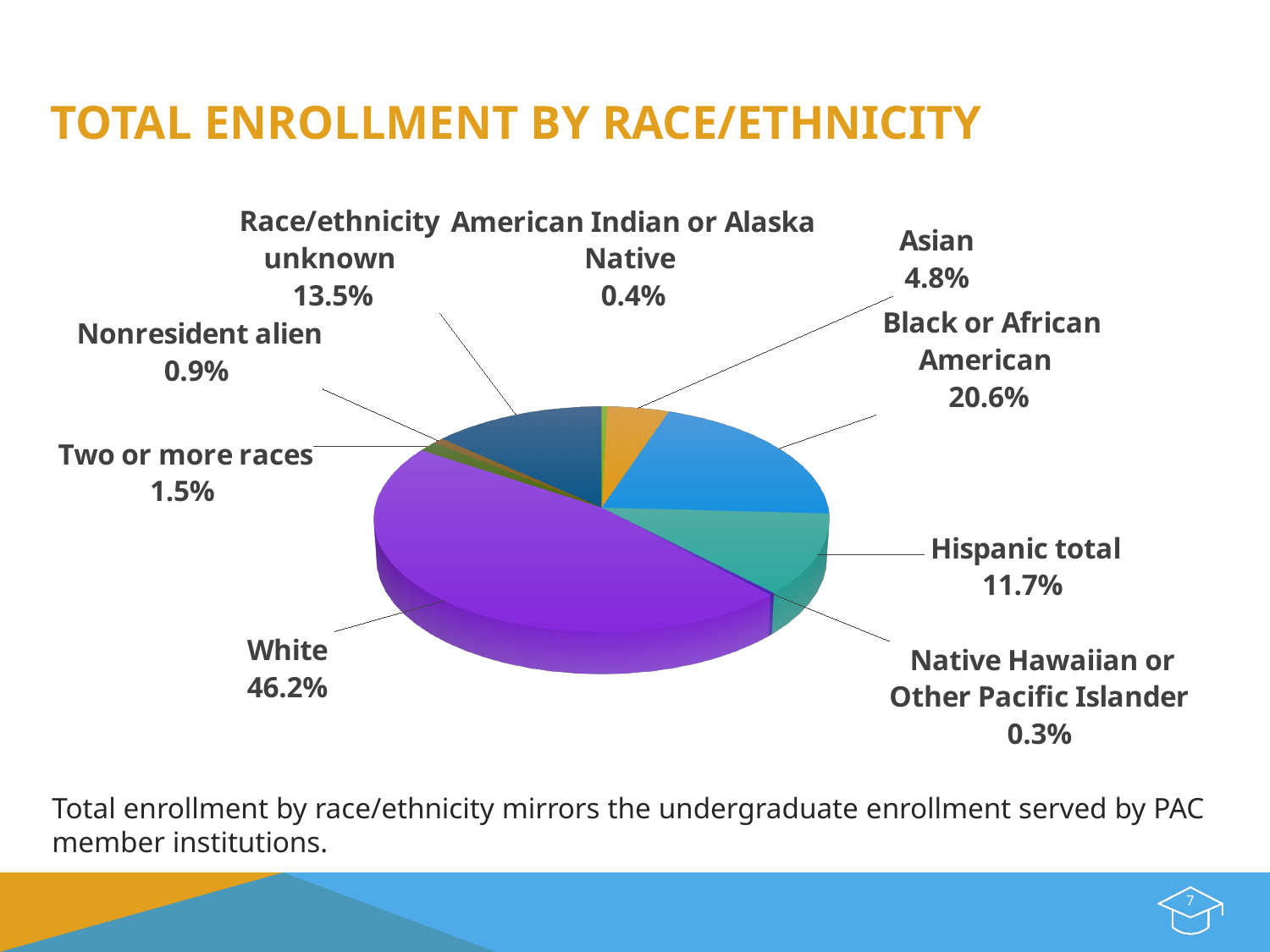
Which race/ethnicity category has the largest share of total enrollment? White Which race/ethnicity category has the smallest share of total enrollment? Native Hawaiian or Other Pacific Islander What is the difference in percentage points between the White share and the Black or African American share? 25.6 What is the title of the slide? TOTAL ENROLLMENT BY RACE/ETHNICITY What share of total enrollment is Native Hawaiian or Other Pacific Islander? 0.3% What share of total enrollment is Race/ethnicity unknown? 13.5% What kind of chart is shown on the slide? Pie chart How many race/ethnicity categories are shown in the pie chart? 9 What share of total enrollment is Black or African American? 20.6% What share of total enrollment is Hispanic total? 11.7% What share of total enrollment is White? 46.2% Which is larger, the Asian share or the Hispanic total share? Hispanic total